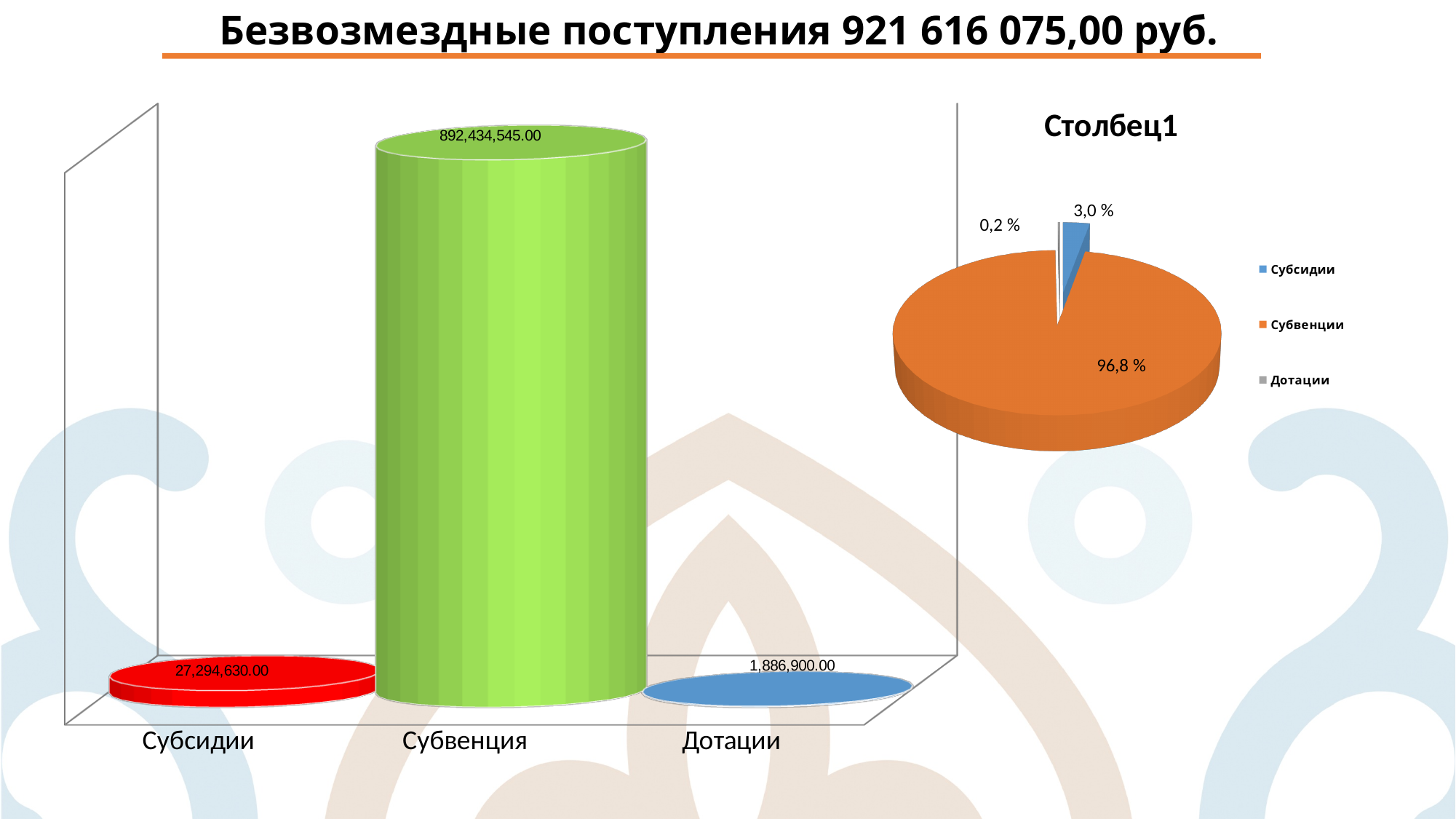
In the pie chart titled Столбец1, what share does Субвенции have? 96,8 % How many series does the legend of the pie chart titled Столбец1 list? 3 In the pie chart titled Столбец1, what share does Субсидии have? 3,0 % In the bar chart on the left, what is the value for Субсидии? 27,294,630.00 In the bar chart on the left, which category has the lowest value? Дотации In the bar chart on the left, which is larger, the value for Субсидии or the value for Дотации? Субсидии In the bar chart on the left, what is the value for Дотации? 1,886,900.00 In the bar chart on the left, what is the difference between the values for Субсидии and Дотации? 25,407,730.00 How many categories are shown in the bar chart on the left? 3 In the bar chart on the left, what is the value for Субвенция? 892,434,545.00 What kind of chart is the chart on the left of the slide? Bar chart In the bar chart on the left, which category has the highest value? Субвенция